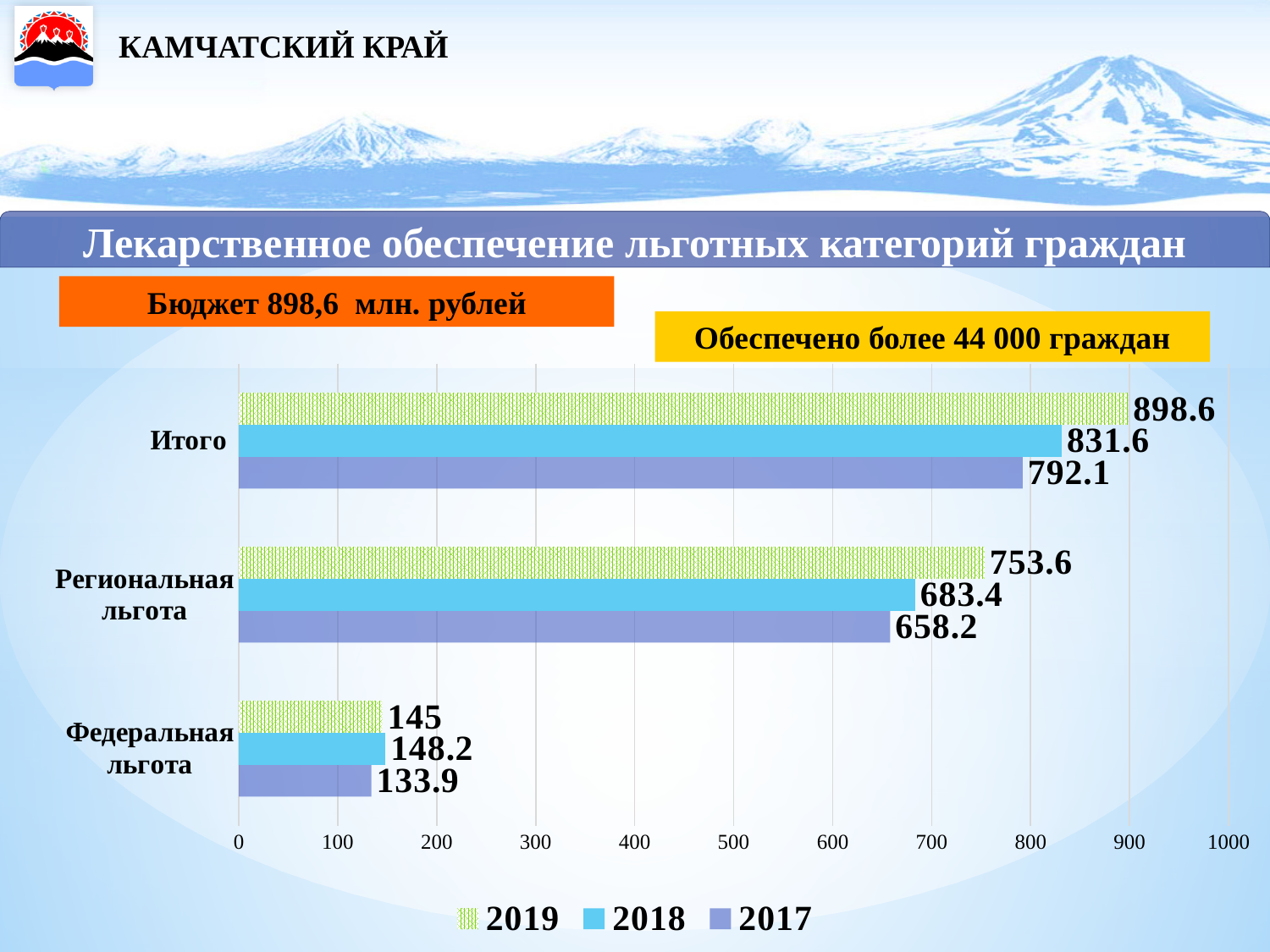
What is the value for Итого in 2019? 898.6 What is the difference between the 2019 and 2018 values for Итого? 67.0 Which category has the lowest value in 2019? Федеральная льгота Which category has the highest value in 2017? Итого What is the value for Федеральная льгота in 2018? 148.2 How many series does the legend list? 3 What is the difference between the 2018 and 2017 values for Региональная льгота? 25.2 Which is larger for Федеральная льгота: the 2019 value or the 2018 value? 2018 What kind of chart is shown on the slide? bar chart What is the value for Региональная льгота in 2017? 658.2 How many categories are shown on the chart? 3 Is the 2018 value for Региональная льгота greater or less than 700? less